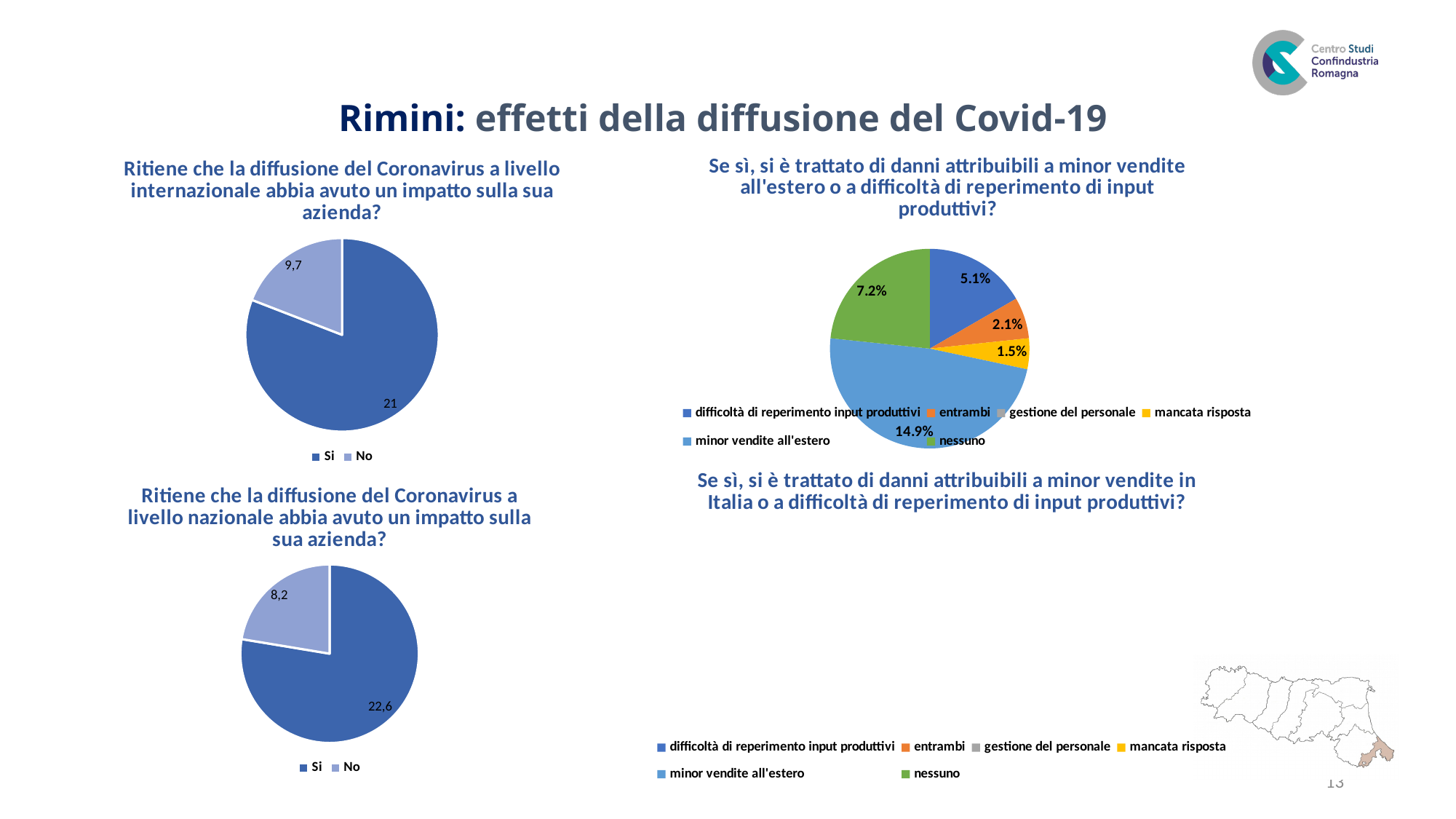
How many entries does the legend of the top-right pie chart (danni attribuibili a minor vendite all'estero) list? 6 In the bottom-left pie chart (impact of the national spread of Coronavirus), what is the value for 'Si'? 22,6 In the top-right pie chart (danni attribuibili a minor vendite all'estero), what is the value for 'nessuno'? 7.2% In the top-left pie chart (impact of the international spread of Coronavirus), what is the value for 'Si'? 21 In the bottom-left pie chart (impact of the national spread of Coronavirus), what is the value for 'No'? 8,2 In the top-right pie chart (danni attribuibili a minor vendite all'estero), which category has the largest slice? minor vendite all'estero In the top-left pie chart (impact of the international spread of Coronavirus), what is the value for 'No'? 9,7 In the bottom-left pie chart (impact of the national spread of Coronavirus), which is larger, 'Si' or 'No'? Si In the top-right pie chart (danni attribuibili a minor vendite all'estero), what is the value for 'minor vendite all'estero'? 14.9% In the top-right pie chart (danni attribuibili a minor vendite all'estero), which labelled slice is the smallest? mancata risposta In the top-left pie chart (impact of the international spread of Coronavirus), what is the difference between the 'Si' and 'No' values? 11,3 What kind of chart is the top-left chart on the slide? Pie chart